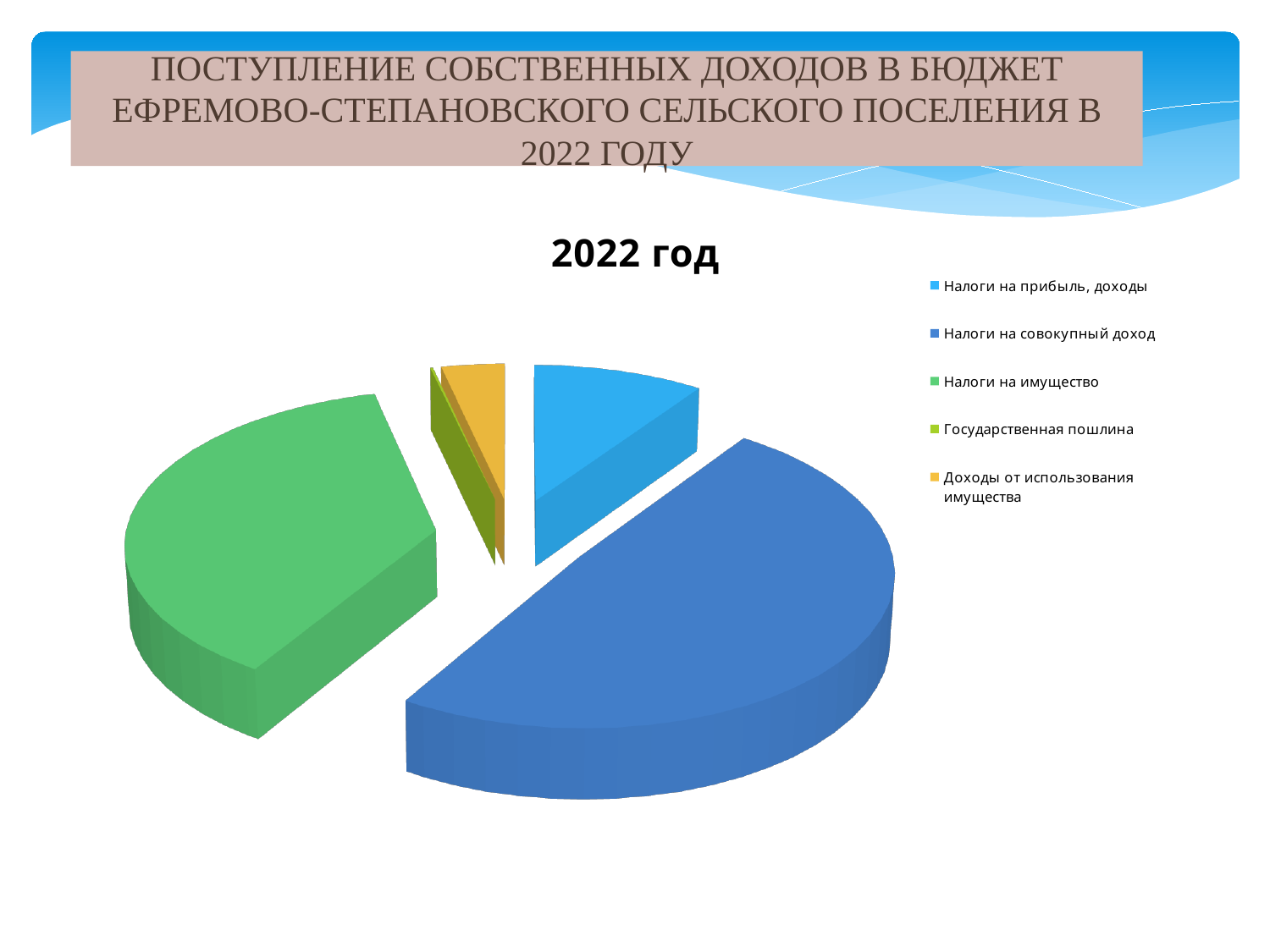
Which slice is larger: Налоги на прибыль, доходы or Доходы от использования имущества? Налоги на прибыль, доходы Which category is shown in green in the legend? Налоги на имущество Which slice is larger: Налоги на имущество or Государственная пошлина? Налоги на имущество Which category has the largest slice of the pie? Налоги на совокупный доход What kind of chart is shown on the slide? pie chart How many categories does the pie chart have? 5 Which slice is larger: Налоги на совокупный доход or Налоги на имущество? Налоги на совокупный доход What is the title of the chart? 2022 год Which category is listed last in the legend? Доходы от использования имущества